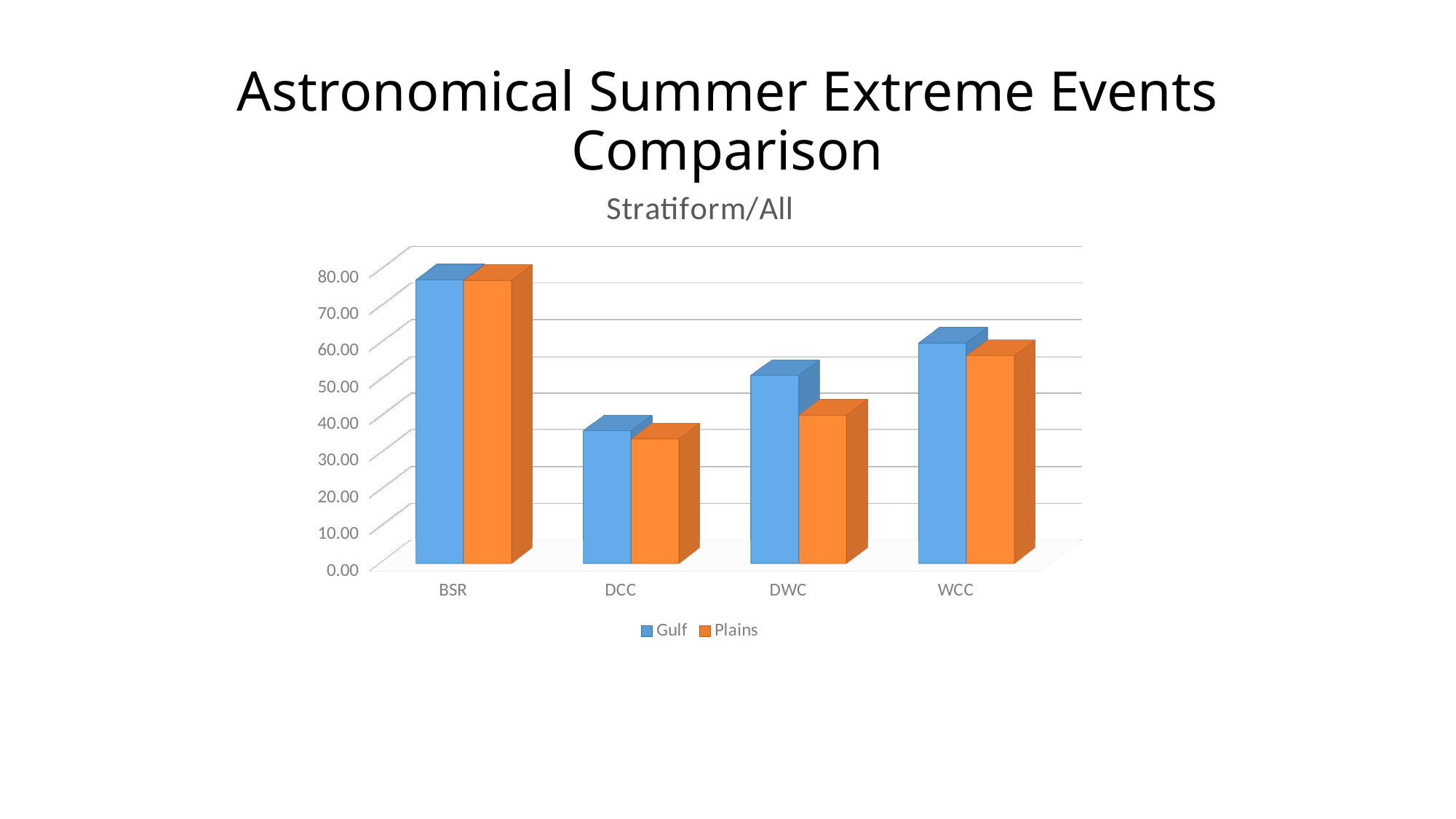
How many categories are shown on the x axis? 4 How many series does the legend list? 2 For DWC, which series has the larger value, Gulf or Plains? Gulf Which category has the highest Gulf value? BSR Is the Plains value for DWC greater or less than 50? less What kind of chart is shown on the slide? Bar chart Is the Gulf value for WCC greater or less than 50? greater Which colour represents the Plains series in the legend? Orange Which category has the lowest Plains value? DCC What is the title of the chart? Stratiform/All Is the Plains value for DCC greater or less than 40? less